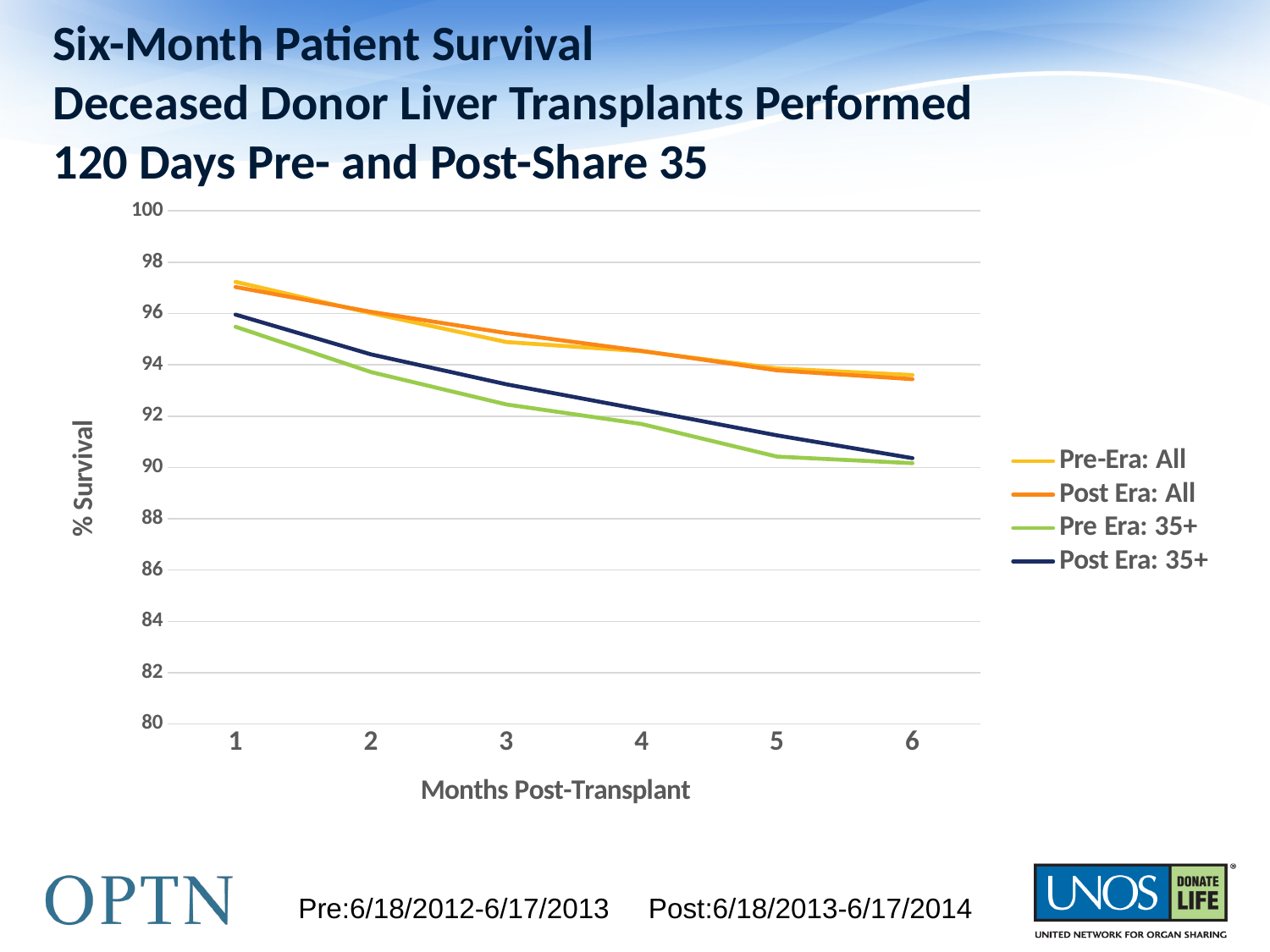
How many months are plotted along the x axis? 6 Is the value for Pre-Era: All at month 1 greater or less than 96? greater How many series does the legend list? 4 Is the value for Pre Era: 35+ at month 3 greater or less than 94? less Is the value for Post Era: All at month 6 greater or less than 94? less What kind of chart is shown on the slide? line chart Do the survival values rise or fall as months post-transplant increase? fall At month 5, which is larger: Post Era: 35+ or Pre Era: 35+? Post Era: 35+ At month 6, which is larger: Pre-Era: All or Pre Era: 35+? Pre-Era: All What is the title of the y axis? % Survival